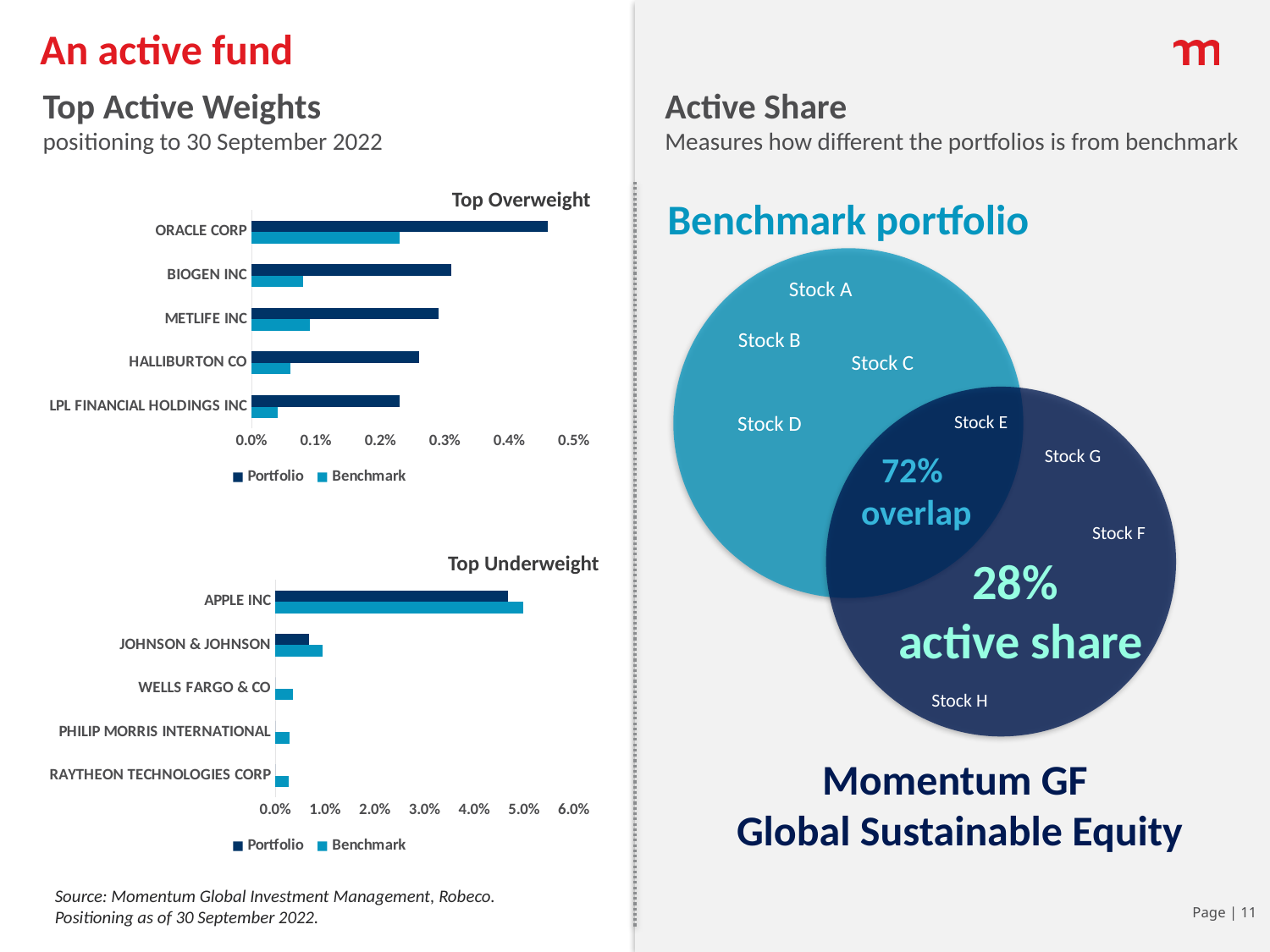
In the Top Underweight chart, which is larger for APPLE INC, the Portfolio or the Benchmark value? Benchmark In the Top Underweight chart, is the Benchmark value for APPLE INC greater or less than 4.0%? greater In the Top Overweight chart, is the Portfolio value for ORACLE CORP greater or less than 0.4%? greater How many companies are shown in the Top Overweight chart? 5 How many series does the legend of the Top Overweight chart list? 2 In the Top Underweight chart, which company has the highest Benchmark weight? APPLE INC In the Top Underweight chart, is the Benchmark value for JOHNSON & JOHNSON greater or less than 2.0%? less What is the title of the lower bar chart on the slide? Top Underweight What kind of chart is the Top Overweight chart? bar chart In the Top Overweight chart, which company has the highest Portfolio weight? ORACLE CORP In the Top Overweight chart, which is larger for BIOGEN INC, the Portfolio or the Benchmark value? Portfolio